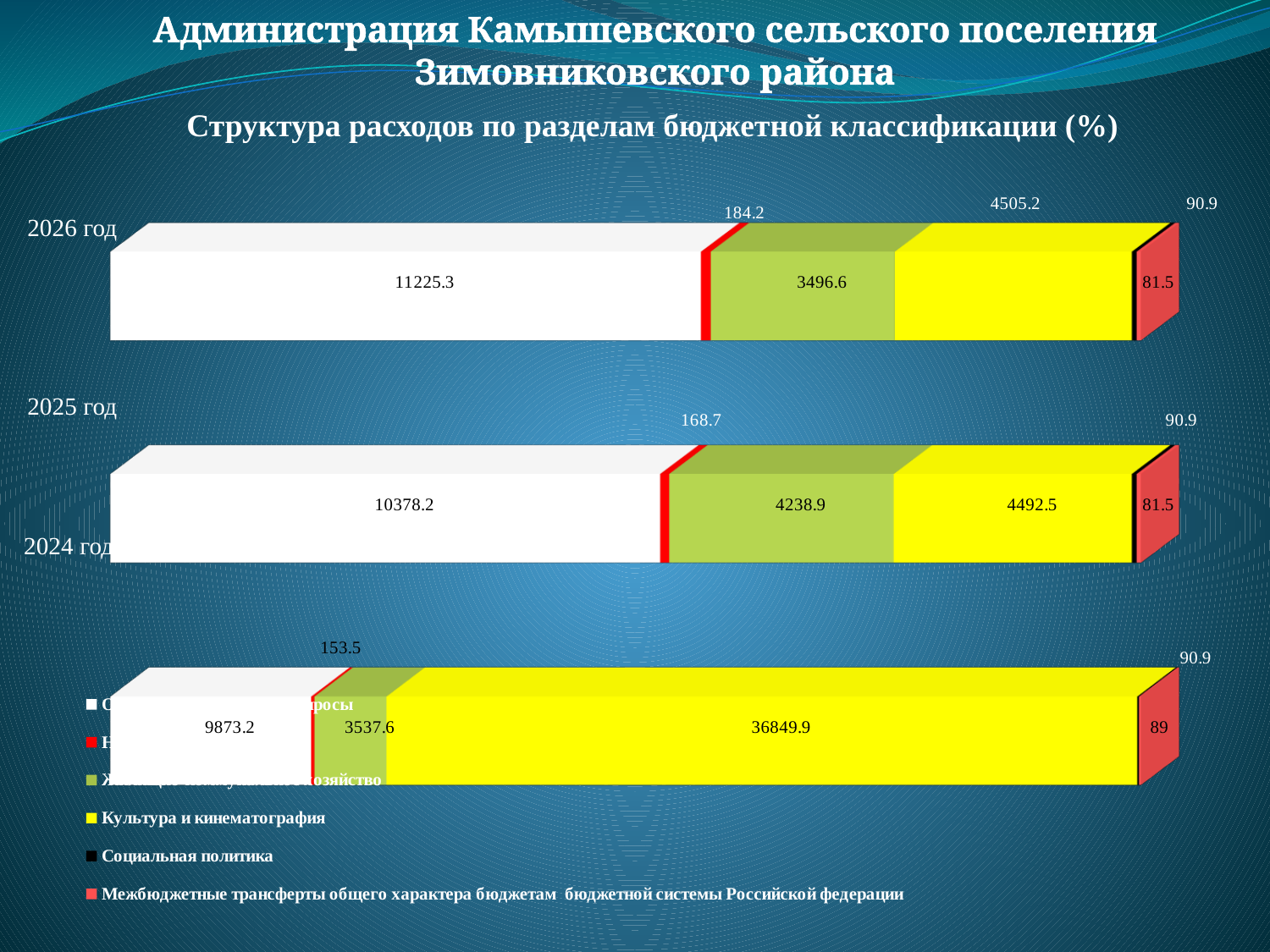
Which colour represents Культура и кинематография in the chart? Yellow What is the value for Социальная политика in the 2026 год bar? 90.9 What is the value for Культура и кинематография in the 2025 год bar? 4492.5 What is the value for Межбюджетные трансферты общего характера бюджетам бюджетной системы Российской федерации in the 2024 год bar? 89 How many years (bars) are shown in the chart? 3 What is the value for Культура и кинематография in the 2024 год bar? 36849.9 What is the total of the 2026 год stacked bar? 19583.7 Which year has the larger value for Межбюджетные трансферты общего характера бюджетам бюджетной системы Российской федерации, 2024 год or 2025 год? 2024 год What kind of chart is shown on the slide? Stacked bar chart How many series does the legend list? 6 In which year is the value for Культура и кинематография the highest? 2024 год What is the difference between the Культура и кинематография values for 2026 год and 2025 год? 12.7